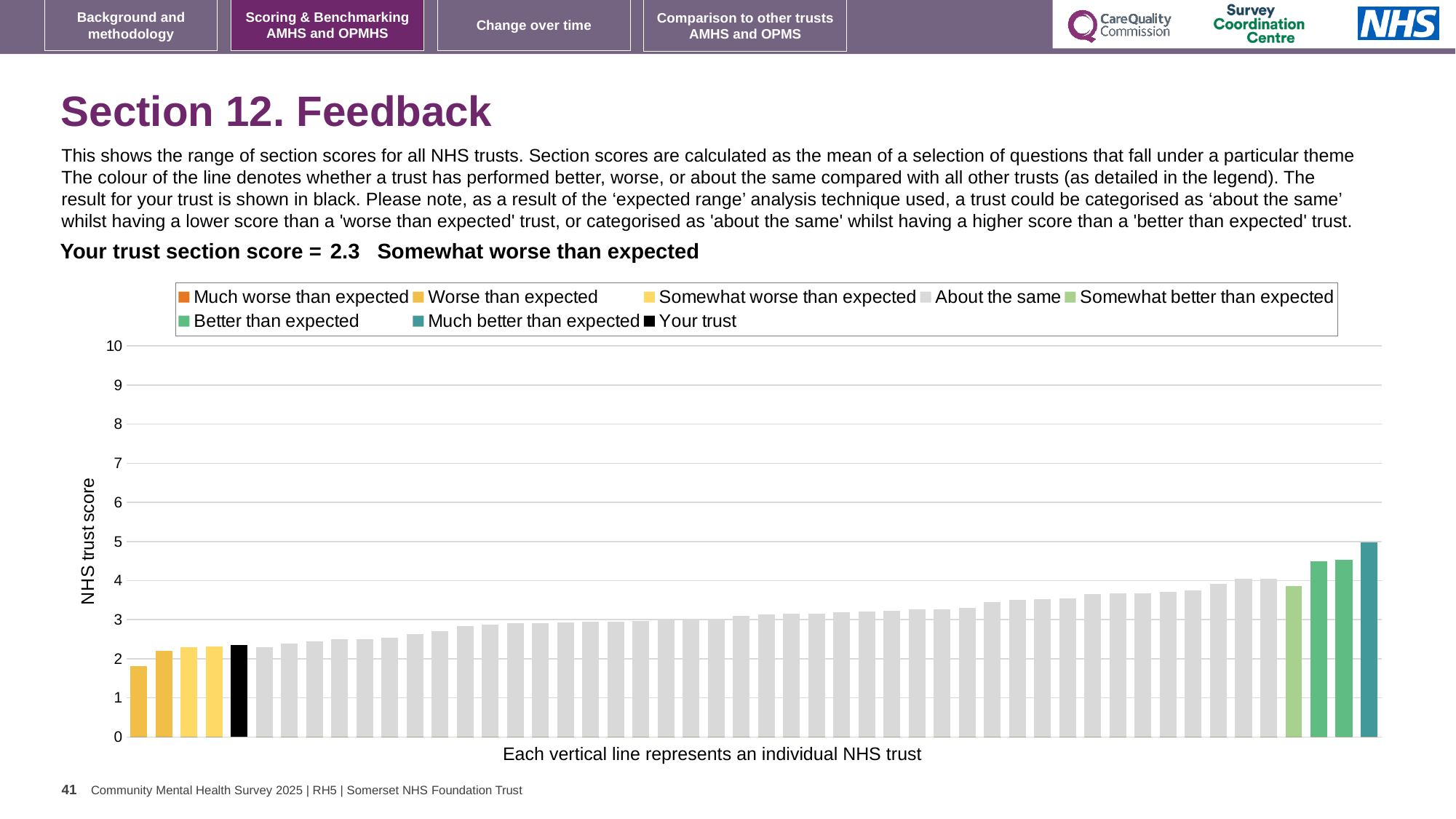
Which legend category does the tallest bar belong to? Much better than expected What is the title of the vertical axis? NHS trust score Is the value of the black 'Your trust' bar greater or less than 3? less Which legend category is your trust placed in for this section? Somewhat worse than expected How many entries does the chart legend list? 8 Is the value of the leftmost (lowest) bar greater or less than 2? less Is the value of the tallest bar on the right greater or less than 4? greater Do the bar values rise or fall moving from left to right along the x axis? rise How many bars are coloured as 'Better than expected' (green)? 2 What kind of chart is shown on the slide? bar chart How many bars are coloured as 'Somewhat worse than expected' (light yellow)? 2 What is the section score for your trust shown on the slide? 2.3